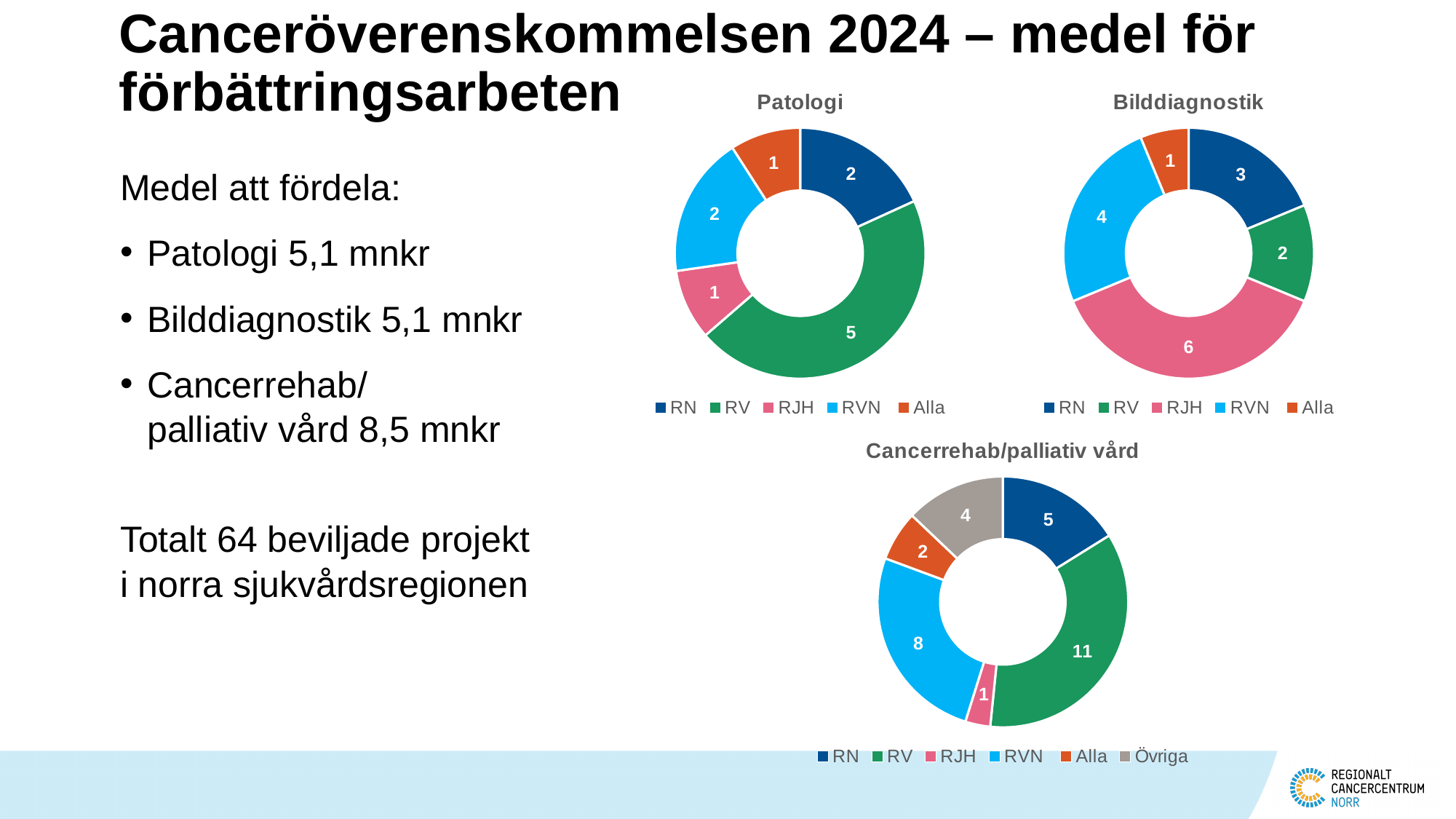
In the Cancerrehab/palliativ vård chart, which category has the highest value? RV In the Patologi chart, what is the value for RV? 5 In the Bilddiagnostik chart, which category has the lowest value? Alla In the Cancerrehab/palliativ vård chart, what is the difference between the values for RV and RVN? 3 In the Bilddiagnostik chart, what is the difference between the values for RJH and RV? 4 Which category appears in the legend of the Cancerrehab/palliativ vård chart but not in the Patologi or Bilddiagnostik charts? Övriga In the Cancerrehab/palliativ vård chart, what is the value for RVN? 8 In the Patologi chart, what share of the total does RV represent? 5 of 11 In the Bilddiagnostik chart, what is the value for RJH? 6 In the Bilddiagnostik chart, which is larger, the value for RN or the value for RVN? RVN What kind of chart is the Patologi chart? Doughnut chart How many categories does the legend of the Cancerrehab/palliativ vård chart list? 6